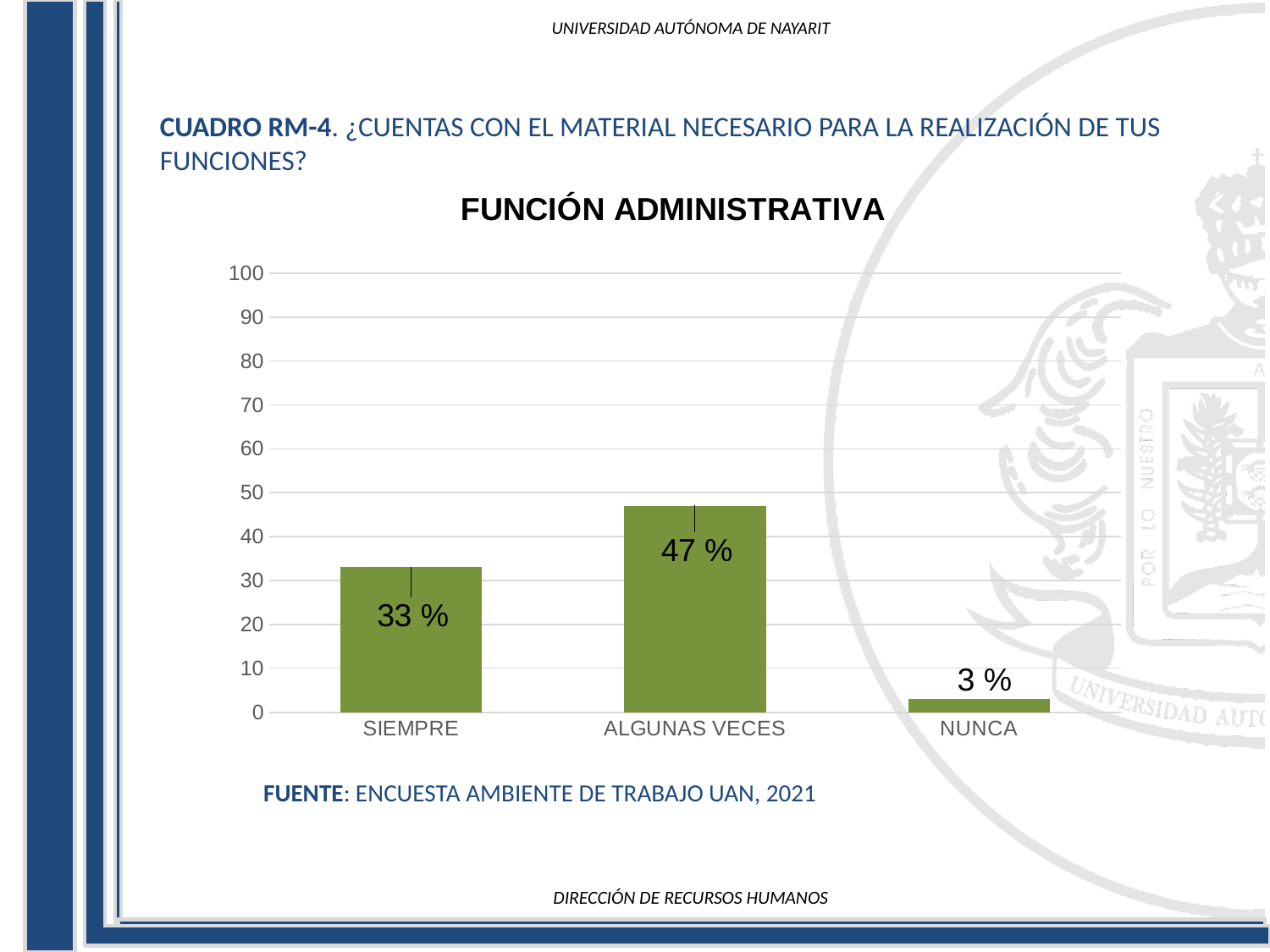
How many categories are shown on the x axis? 3 What is the title of the chart? FUNCIÓN ADMINISTRATIVA What kind of chart is shown on the slide? bar chart What is the value for ALGUNAS VECES? 47 % What is the value for SIEMPRE? 33 % What is the highest value shown on the y axis? 100 Is the value for ALGUNAS VECES greater or less than 40? greater What is the value for NUNCA? 3 % Which category has the lowest value? NUNCA Which is larger, the value for SIEMPRE or the value for NUNCA? SIEMPRE Which category has the highest value? ALGUNAS VECES What is the difference between the values for ALGUNAS VECES and SIEMPRE? 14 %